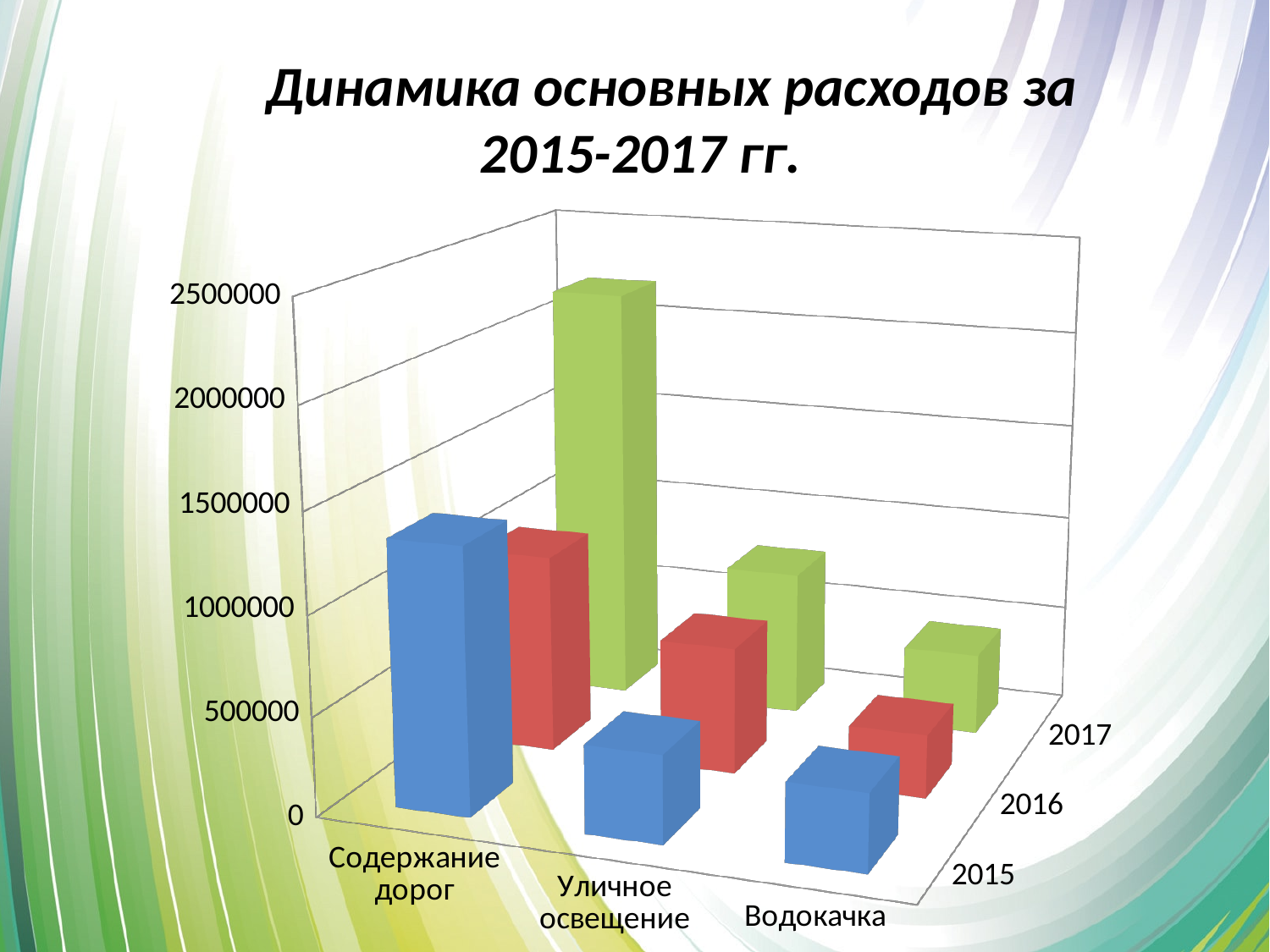
Is the value for Содержание дорог in 2017 greater or less than 2000000? greater What is the title of the chart? Динамика основных расходов за 2015-2017 гг. How many years (series) are plotted on the chart? 3 How many expense categories are shown on the chart? 3 Which category has the highest bar on the chart? Содержание дорог Which is larger in 2017: Содержание дорог or Уличное освещение? Содержание дорог What kind of chart is shown on the slide? bar chart Is the value for Водокачка in 2015 greater or less than 500000? less Is the value for Содержание дорог in 2015 greater or less than 1000000? greater Which category has the lowest bar on the chart? Водокачка Which year is shown with green bars? 2017